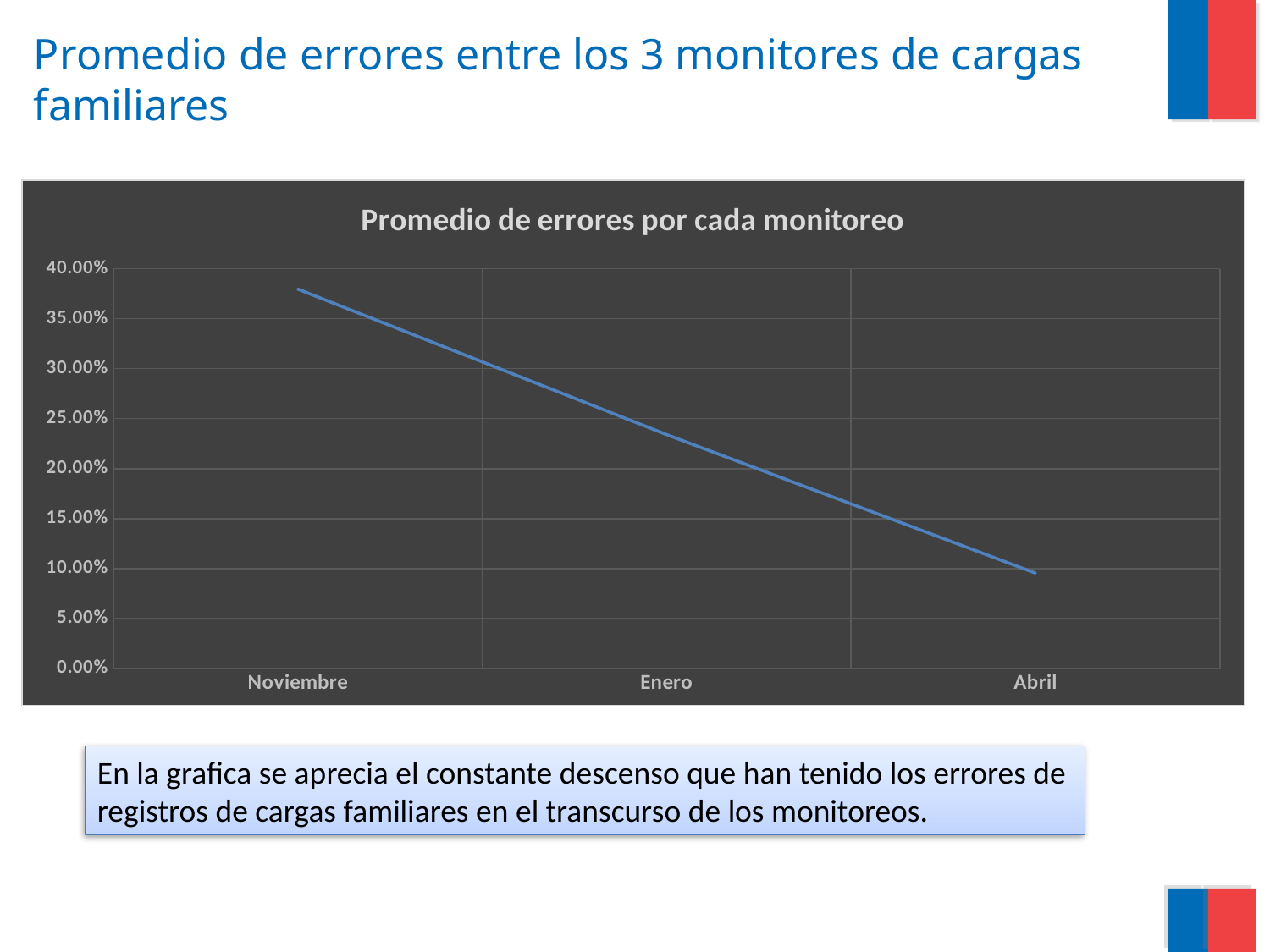
Is the value for Noviembre greater or less than 35.00%? greater Which is larger, the value for Noviembre or the value for Abril? Noviembre Which category has the lowest value? Abril What kind of chart is shown on the slide? line chart What is the title of the chart? Promedio de errores por cada monitoreo Which is larger, the value for Enero or the value for Abril? Enero Is the value for Abril greater or less than 15.00%? less Do the values rise or fall from Noviembre to Abril? fall Is the value for Enero greater or less than 30.00%? less How many points (categories) are plotted on the x axis? 3 Which category has the highest value? Noviembre